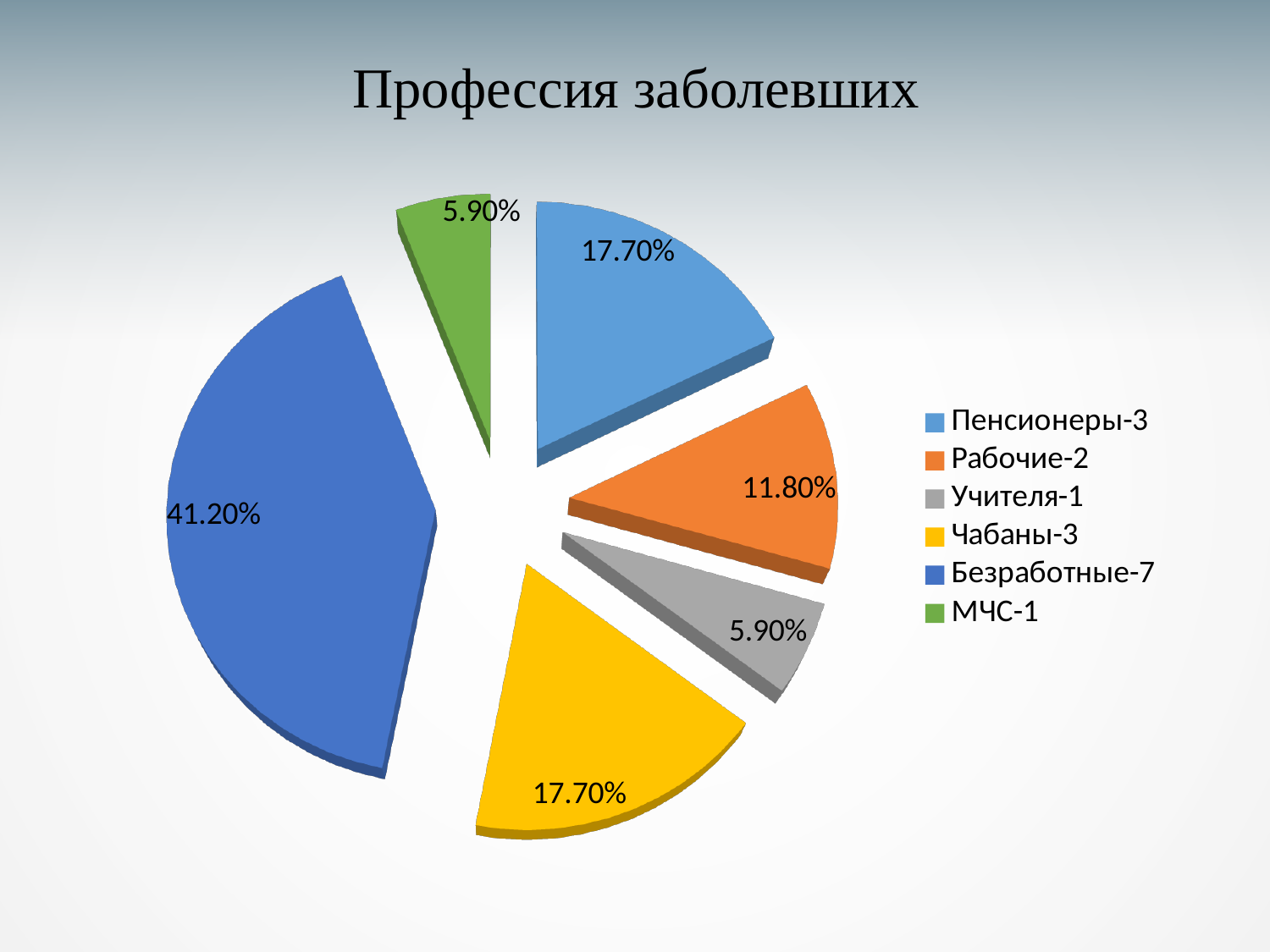
What is the difference between the shares of Безработные-7 and Чабаны-3? 23.50% What kind of chart is shown on the slide? pie chart Which is larger, the share for Рабочие-2 or the share for МЧС-1? Рабочие-2 What is the value shown for Пенсионеры-3? 17.70% What is the value shown for Рабочие-2? 11.80% What is the title of the chart? Профессия заболевших Which colour is used for the Чабаны-3 slice? yellow What share of the pie does Безработные-7 have? 41.20% What is the difference between the shares of Пенсионеры-3 and Рабочие-2? 5.90% What is the value shown for Учителя-1? 5.90% Which category has the largest slice of the pie? Безработные-7 How many categories does the pie chart have? 6